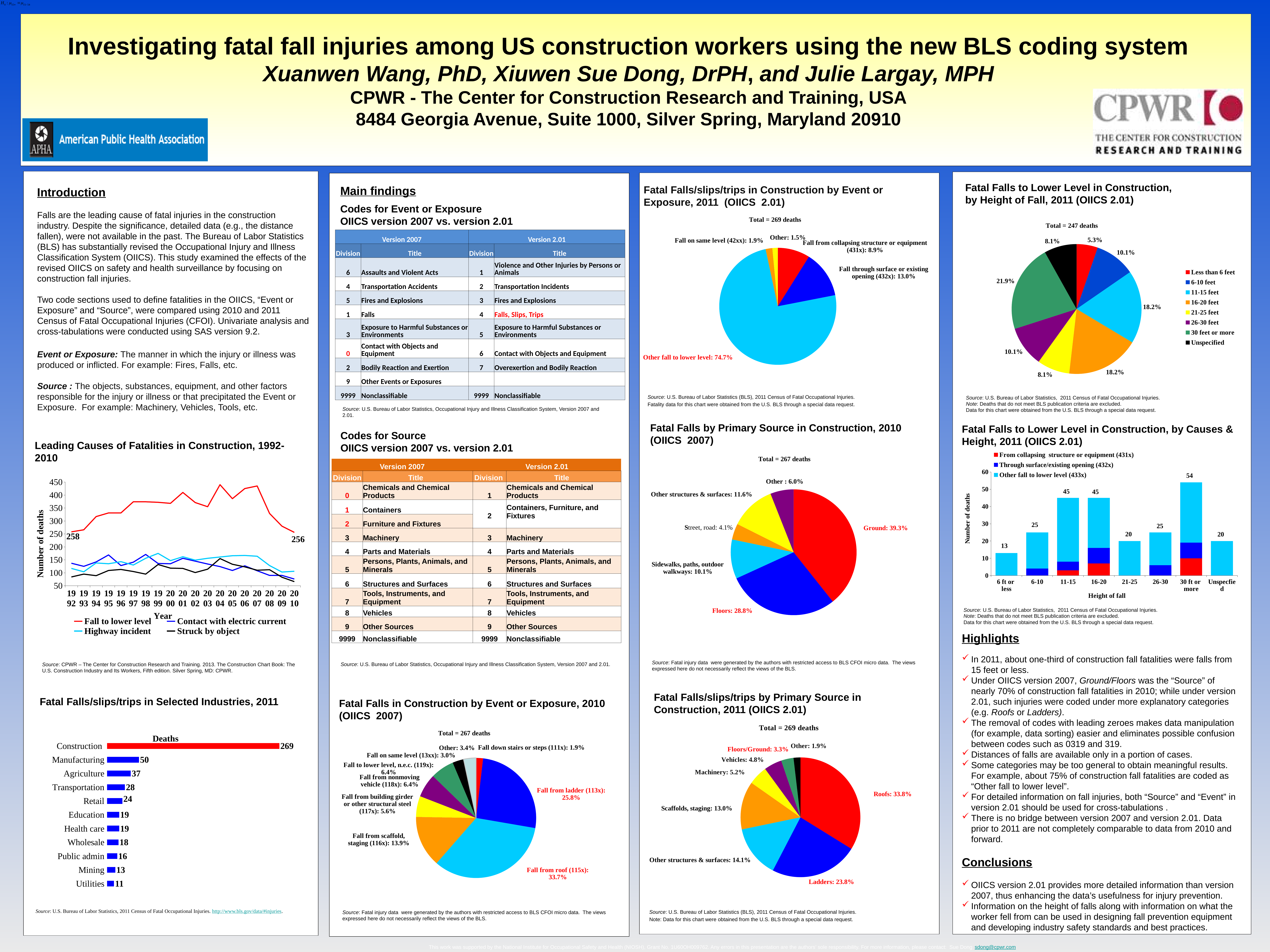
In the 'Fatal Falls/slips/trips in Construction by Event or Exposure, 2011 (OIICS 2.01)' pie chart, what share is 'Other fall to lower level'? 74.7% In the 'Fatal Falls/slips/trips by Primary Source in Construction, 2011 (OIICS 2.01)' pie chart, which is larger: Roofs or Ladders? Roofs In the 'Fatal Falls to Lower Level in Construction, by Causes & Height, 2011' bar chart, what is the total number of deaths for the '30 ft or more' bar? 54 How many series does the legend of the 'Leading Causes of Fatalities in Construction, 1992-2010' chart list? 4 In the 'Fatal Falls by Primary Source in Construction, 2010 (OIICS 2007)' pie chart, which source has the largest share? Ground In the 'Fatal Falls/slips/trips in Selected Industries, 2011' chart, which industry has the lowest number of deaths? Utilities In the 'Fatal Falls/slips/trips in Selected Industries, 2011' chart, what is the difference in deaths between Manufacturing and Agriculture? 13 What type of chart is 'Leading Causes of Fatalities in Construction, 1992-2010'? Line chart In the 'Fatal Falls to Lower Level in Construction, by Height of Fall, 2011' pie chart, what share is '30 feet or more'? 21.9% How many industries are listed in the 'Fatal Falls/slips/trips in Selected Industries, 2011' chart? 11 In the 'Fatal Falls/slips/trips in Selected Industries, 2011' chart, how many deaths are shown for Construction? 269 In the 'Fatal Falls in Construction by Event or Exposure, 2010 (OIICS 2007)' pie chart, what percentage is 'Fall from roof (115x)'? 33.7%